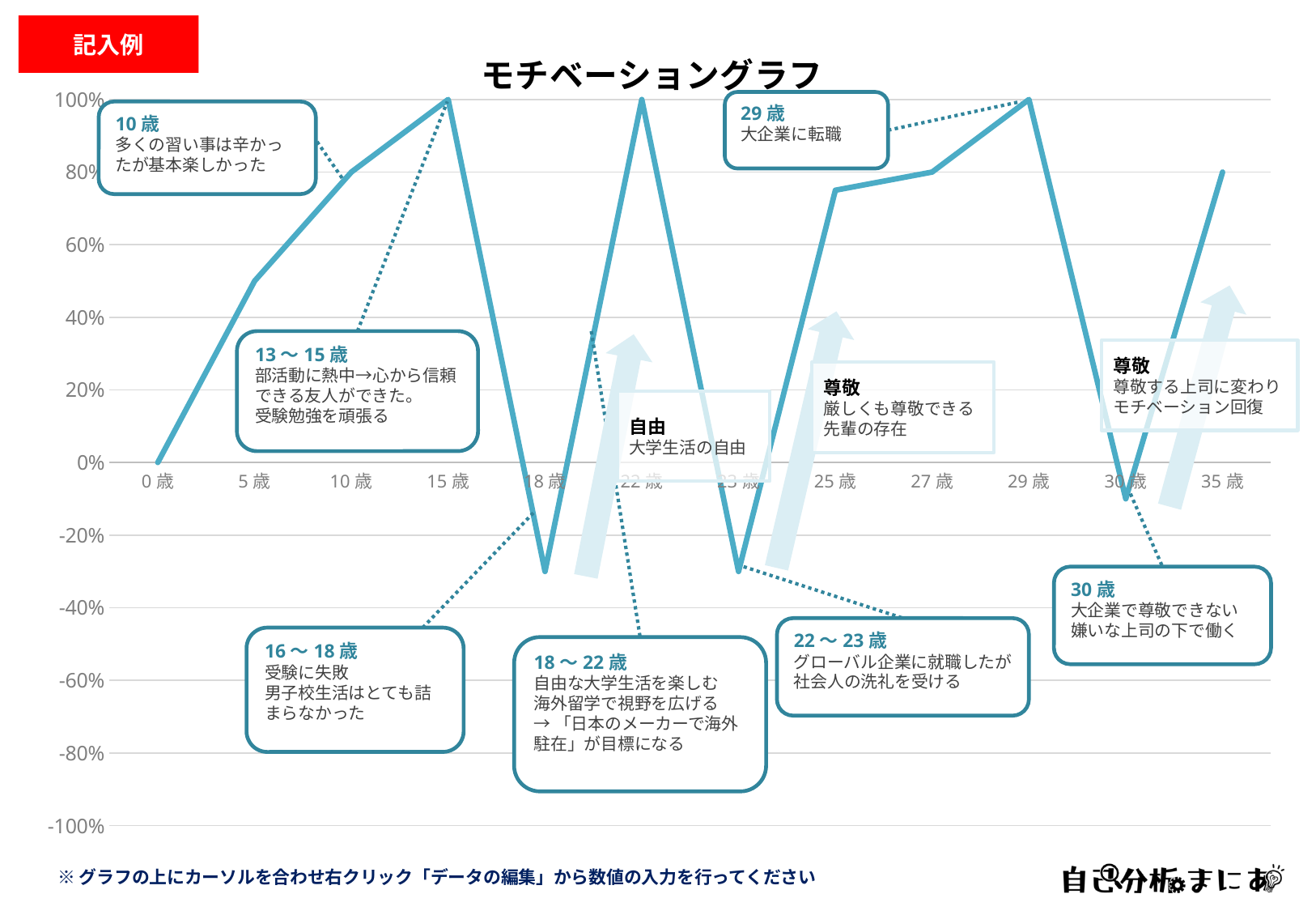
What is the motivation value at 15歳? 100% What is the motivation value at 0歳? 0% Is the value at 30歳 greater or less than 0%? less What is the title of the chart? モチベーショングラフ What kind of chart is shown on the slide? line chart Which is higher, the value at 5歳 or the value at 10歳? 10歳 Does the line rise or fall between 0歳 and 15歳? rise Is the value at 25歳 greater or less than 60%? greater How many age points are labelled on the x axis of the chart? 12 Is the value at 5歳 greater or less than 40%? greater What is the motivation value at 10歳? 80%